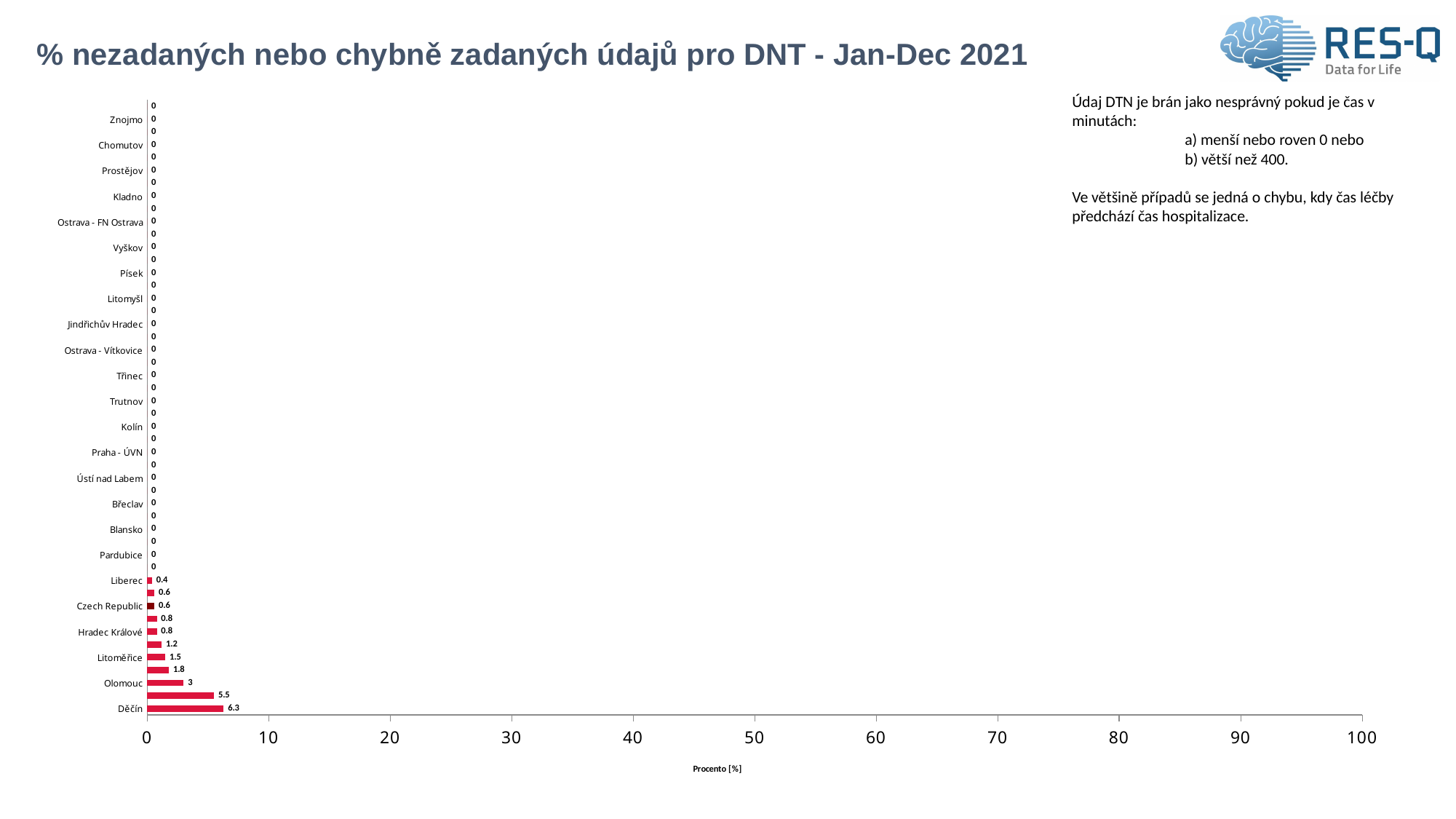
What is the value for Znojmo? 0 What is the difference between the values for Děčín and Olomouc? 3.3 What is the value for Hradec Králové? 0.8 Is the value for Děčín greater or less than 10? less Which has a larger value, Olomouc or Litoměřice? Olomouc What is the value for Olomouc? 3 What is the value for Litoměřice? 1.5 What kind of chart is shown on the slide? bar chart What is the value for Czech Republic? 0.6 What is the value for Liberec? 0.4 What is the value for Děčín? 6.3 Which labelled category has the highest value? Děčín